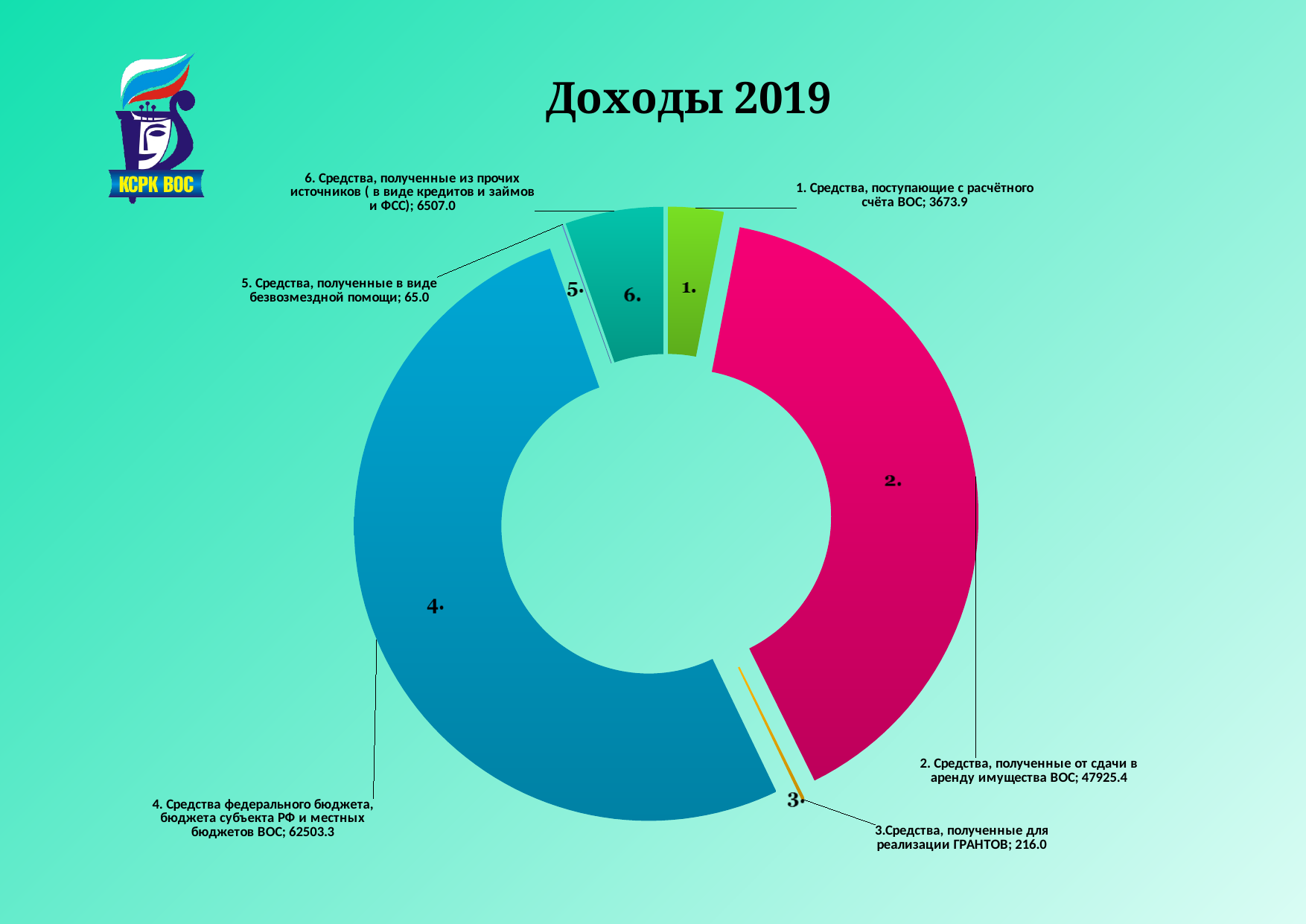
Which category has the largest value? 4. Средства федерального бюджета, бюджета субъекта РФ и местных бюджетов ВОС What is the value for category 4 (Средства федерального бюджета, бюджета субъекта РФ и местных бюджетов ВОС)? 62503.3 How many categories does the chart show? 6 What is the value for category 3 (Средства, полученные для реализации ГРАНТОВ)? 216.0 What is the difference between the values of category 4 and category 2? 14577.9 What kind of chart is shown on the slide? Doughnut (pie) chart What is the title of the chart? Доходы 2019 Which category has the smallest value? 5. Средства, полученные в виде безвозмездной помощи What is the value for category 2 (Средства, полученные от сдачи в аренду имущества ВОС)? 47925.4 Which is larger: the value for category 1 or the value for category 6? Category 6 (6507.0) What is the difference between the values of category 6 and category 1? 2833.1 What is the value for category 6 (Средства, полученные из прочих источников)? 6507.0